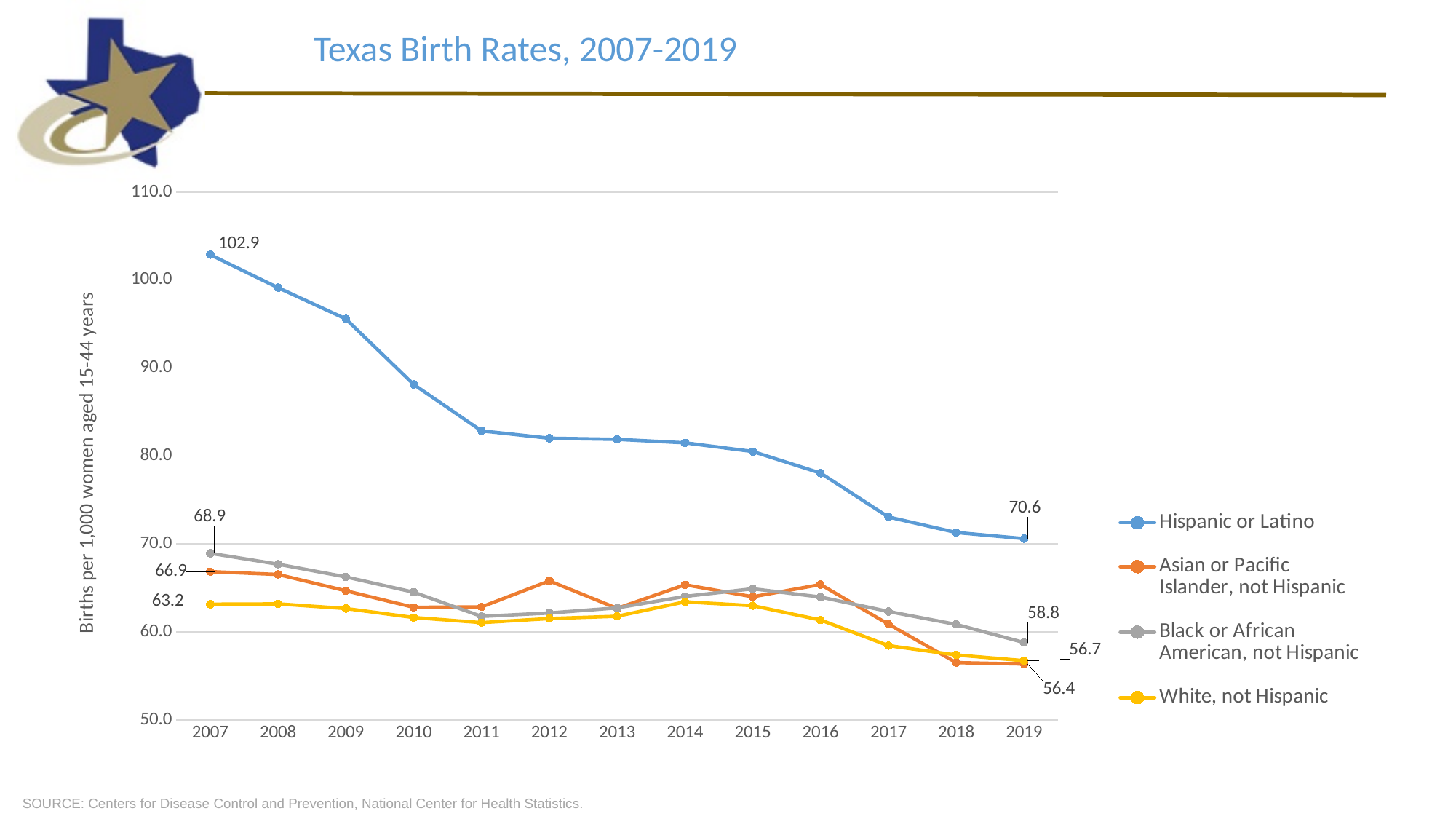
What kind of chart is shown on the slide? Line chart What is the birth rate for Hispanic or Latino women in 2019? 70.6 How many series does the legend list? 4 What is the 2007 value for the Black or African American, not Hispanic series? 68.9 Is the Hispanic or Latino value for 2011 greater or less than 80.0? greater What is the 2019 value for the Asian or Pacific Islander, not Hispanic series? 56.4 What is the 2019 value for the White, not Hispanic series? 56.7 By how much did the Hispanic or Latino birth rate fall from 2007 to 2019? 32.3 Which series has the lowest value in 2019? Asian or Pacific Islander, not Hispanic What is the birth rate for Hispanic or Latino women in 2007? 102.9 How many years are plotted along the x axis? 13 Which series has the highest value in 2007? Hispanic or Latino